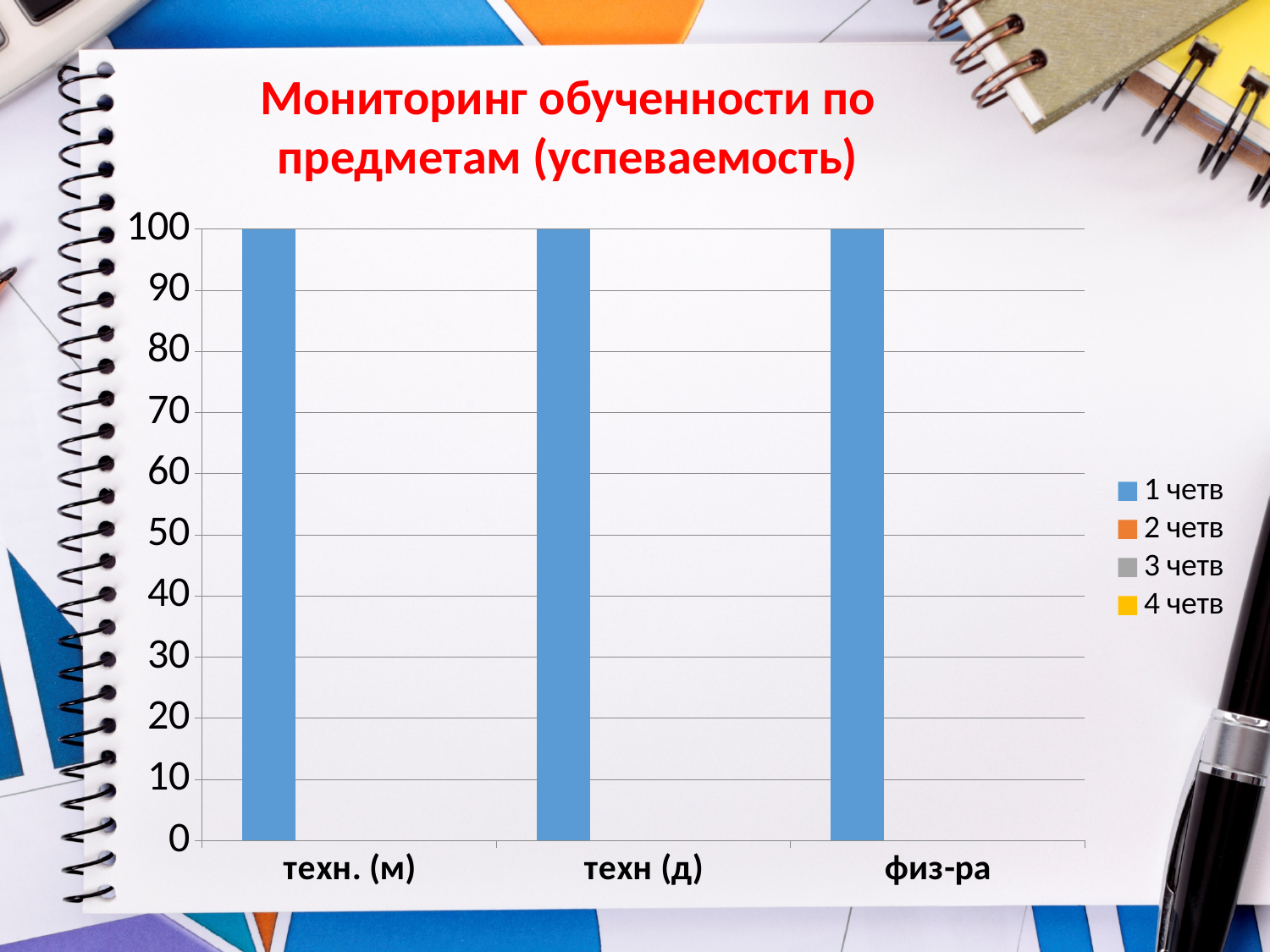
Which legend entry is shown in blue? 1 четв How many categories are shown on the x axis? 3 What is the value for техн (д) in the 1 четв series? 100 Do the values rise, fall or stay the same across the categories from техн. (м) to физ-ра? stay the same What type of chart is shown on the slide? bar chart How many series does the legend list? 4 Is the value for физ-ра greater or less than 50? greater What is the value for физ-ра in the 1 четв series? 100 What is the value for техн. (м) in the 1 четв series? 100 Is the value for техн. (м) greater or less than 90? greater What is the difference between the values for техн. (м) and физ-ра? 0 What is the title of the chart? Мониторинг обученности по предметам (успеваемость)